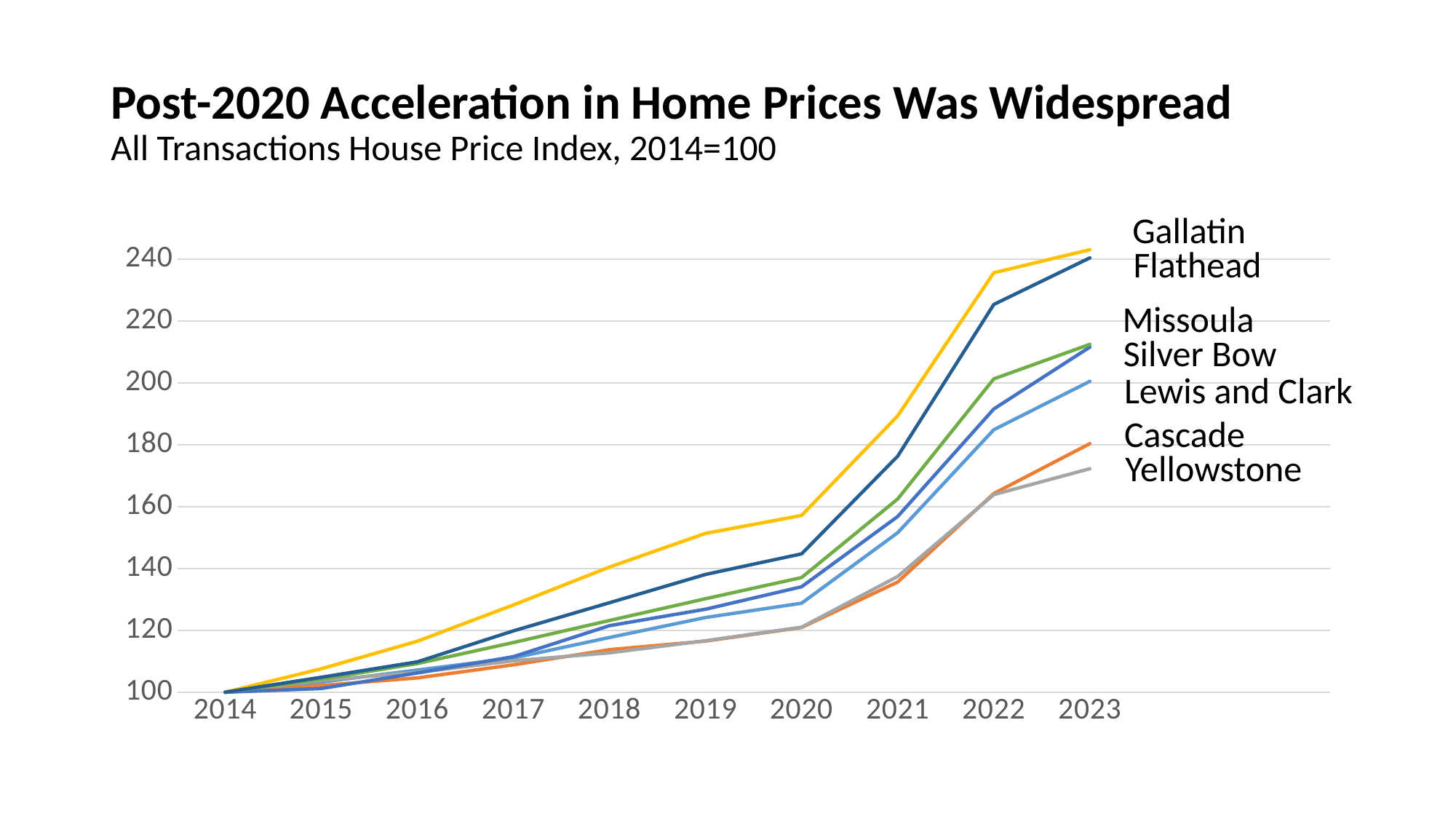
Is the value for Gallatin in 2022 greater or less than 220? greater What kind of chart is shown on the slide? line chart Which county has the lowest house price index in 2023? Yellowstone Which county has the highest house price index in 2023? Gallatin What is the title of the chart? Post-2020 Acceleration in Home Prices Was Widespread Do the house price index lines generally rise or fall from 2014 to 2023? rise Is the value for Missoula in 2023 greater or less than 200? greater In 2023, which is higher: the index for Missoula or the index for Cascade? Missoula How many series (counties) are plotted on the chart? 7 Is the value for Flathead in 2021 greater or less than 160? greater How many years are shown along the x axis? 10